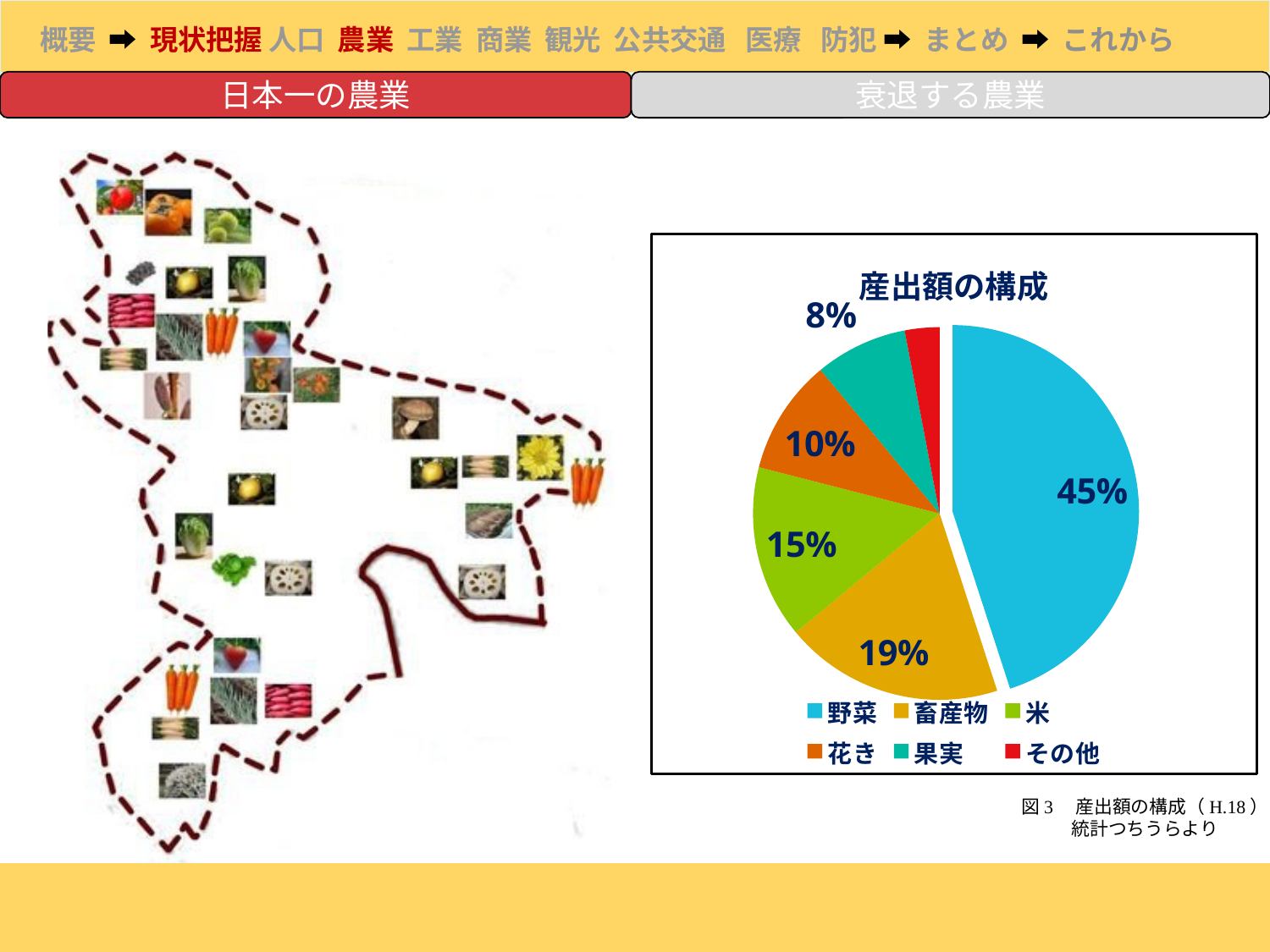
What is the difference in percentage points between the shares of 野菜 and 畜産物? 26 Which category has the largest share of the pie? 野菜 What kind of chart is shown on the slide? pie chart What share of the pie does 花き account for? 10% What share of the pie does 畜産物 account for? 19% Which category has the smallest share of the pie? その他 What is the title of the pie chart? 産出額の構成 How many categories does the legend of the pie chart list? 6 What share of the pie does 果実 account for? 8% Which has a larger share, 米 or 花き? 米 What share of the pie does 米 account for? 15% What share of the pie does 野菜 account for? 45%